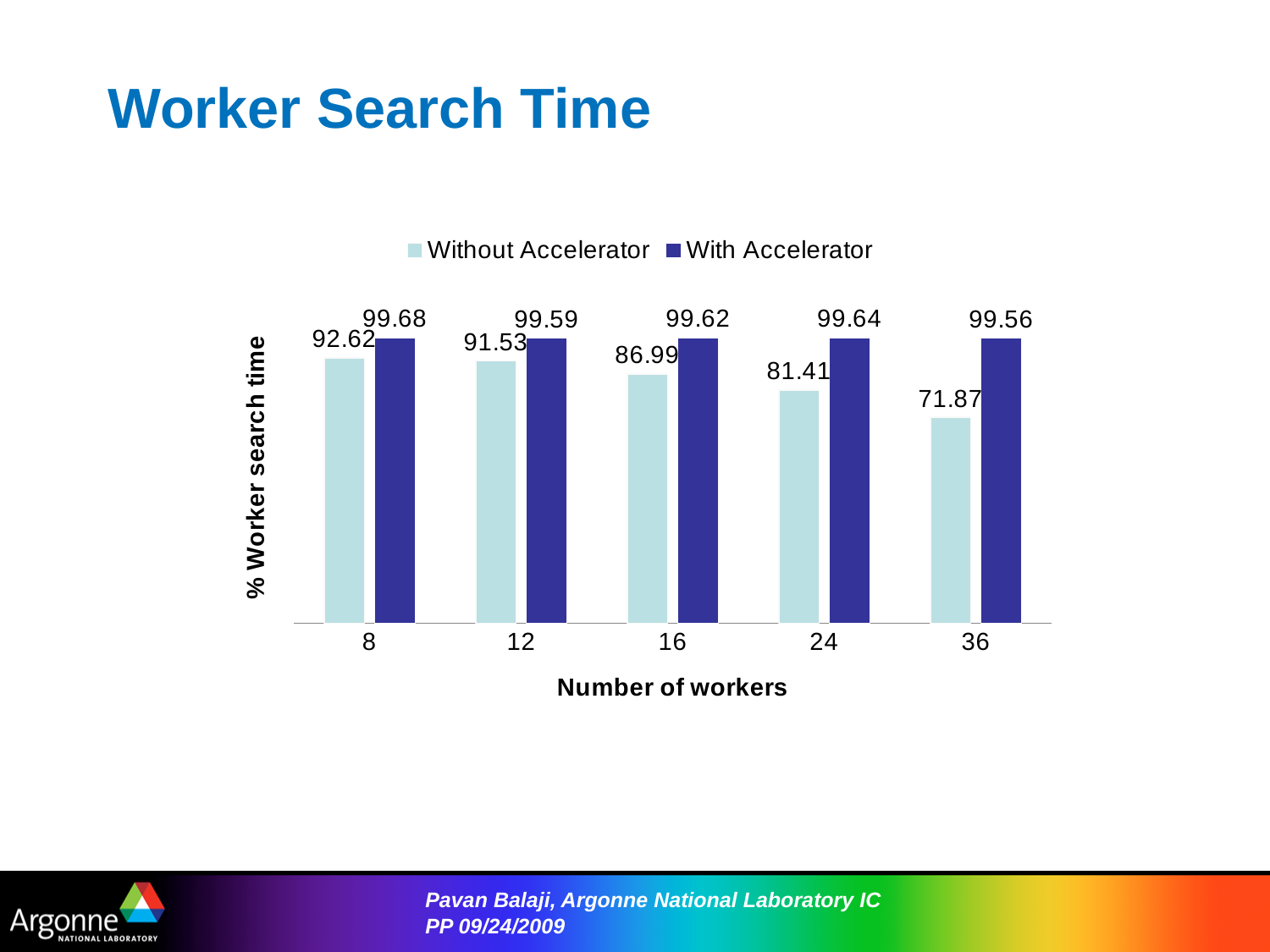
Which number of workers has the lowest % worker search time without accelerator? 36 Which number of workers has the highest % worker search time without accelerator? 8 Which is larger for 16 workers: the value with accelerator or without accelerator? With Accelerator What is the difference between the without-accelerator values for 8 workers and 16 workers? 5.63 What is the % worker search time with accelerator for 36 workers? 99.56 What is the difference between the with-accelerator and without-accelerator values for 36 workers? 27.69 What is the % worker search time without accelerator for 24 workers? 81.41 What is the % worker search time without accelerator for 8 workers? 92.62 How many series does the legend list? 2 How many worker counts are shown on the x axis? 5 What kind of chart is shown on the slide? Bar chart Do the without-accelerator values rise or fall as the number of workers increases? Fall